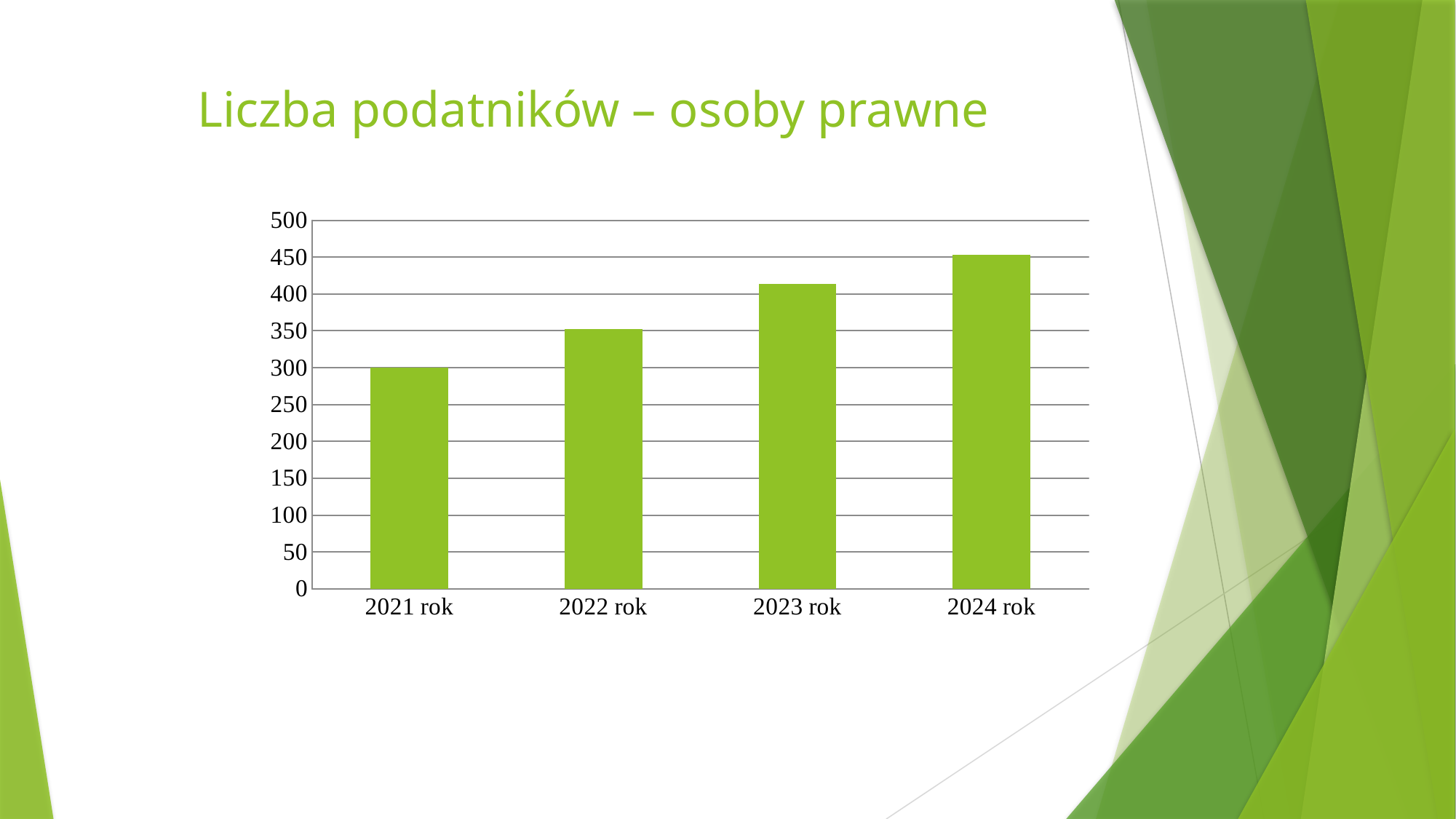
Is the value for 2023 rok greater or less than 400? greater Which is larger, the value for 2022 rok or the value for 2023 rok? 2023 rok What kind of chart is shown on the slide? bar chart Is the value for 2024 rok greater or less than 500? less Is the value for 2022 rok greater or less than 300? greater How many categories (years) are shown on the x axis? 4 What colour are the bars in the chart? green Do the values rise or fall from 2021 rok to 2024 rok? rise Which year has the lowest value? 2021 rok What is the title of the chart? Liczba podatników – osoby prawne Which year has the highest value? 2024 rok